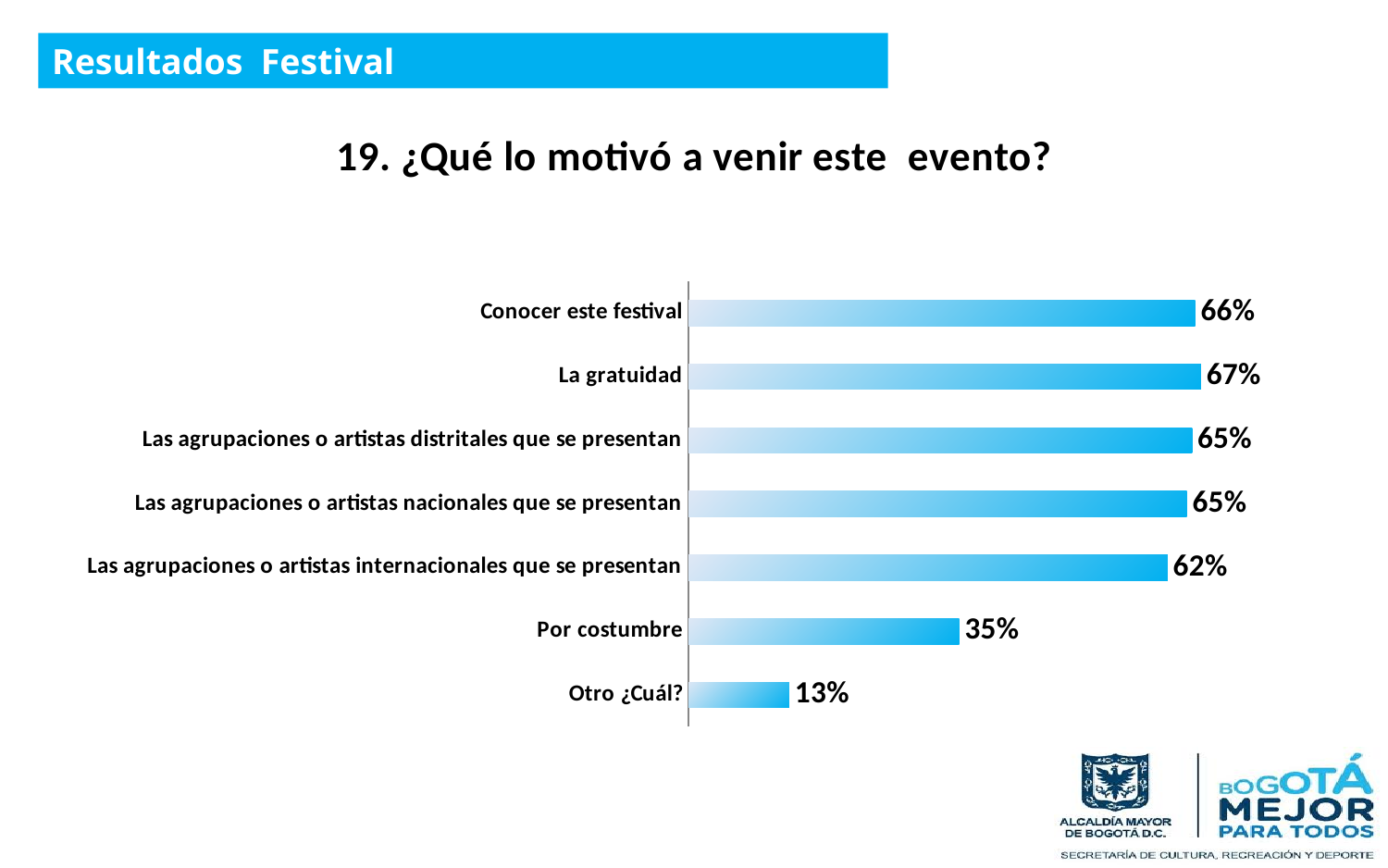
What is the value for "La gratuidad"? 67% How many categories are shown in the chart? 7 What is the value for "Las agrupaciones o artistas internacionales que se presentan"? 62% Which category has the lowest value? Otro ¿Cuál? What is the difference between the values for "Por costumbre" and "Otro ¿Cuál?"? 22% Which is larger: the value for "Conocer este festival" or the value for "Por costumbre"? Conocer este festival Which category has the highest value? La gratuidad What is the difference between the values for "La gratuidad" and "Las agrupaciones o artistas internacionales que se presentan"? 5% What is the title of the chart? 19. ¿Qué lo motivó a venir este evento? What is the value for "Conocer este festival"? 66% What kind of chart is shown on the slide? Bar chart What is the value for "Por costumbre"? 35%